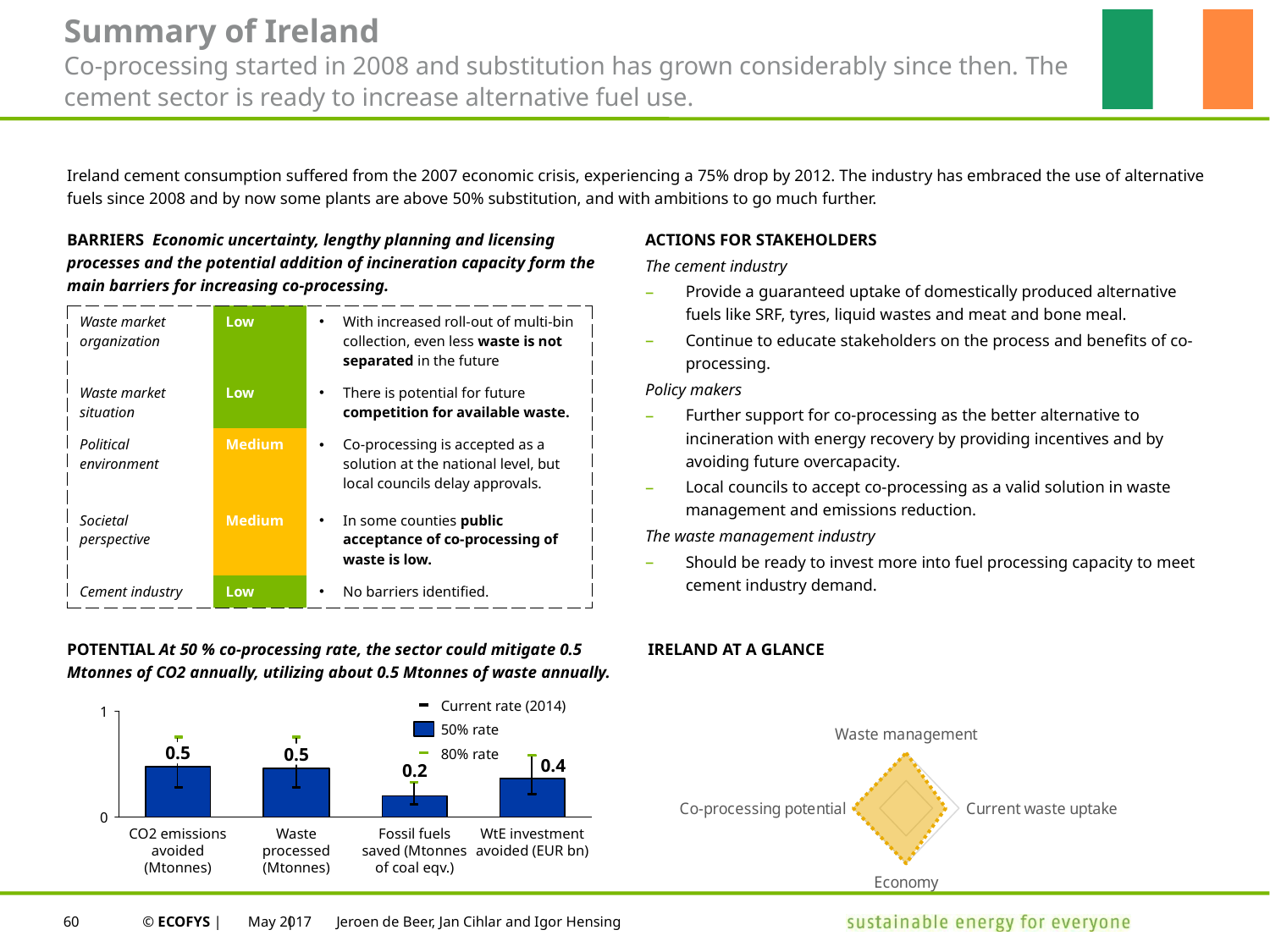
In the bar chart under POTENTIAL, what is the 50% rate value for Fossil fuels saved (Mtonnes of coal eqv.)? 0.2 In the bar chart under POTENTIAL, what is the 50% rate value for WtE investment avoided (EUR bn)? 0.4 In the bar chart under POTENTIAL, what is the 50% rate value for Waste processed (Mtonnes)? 0.5 In the bar chart under POTENTIAL, is the 50% rate value for WtE investment avoided greater or less than 1? less In the bar chart under POTENTIAL, which is larger at the 50% rate: Waste processed or WtE investment avoided? Waste processed In the bar chart under POTENTIAL, what is the difference between the 50% rate values for CO2 emissions avoided and Fossil fuels saved? 0.3 How many series does the legend of the bar chart under POTENTIAL list? 3 In the bar chart under POTENTIAL, what is the 50% rate value for CO2 emissions avoided (Mtonnes)? 0.5 In the bar chart under POTENTIAL, which category has the lowest 50% rate value? Fossil fuels saved (Mtonnes of coal eqv.) In the IRELAND AT A GLANCE radar chart, what are the four axis labels? Waste management, Current waste uptake, Economy, Co-processing potential How many categories are shown on the x axis of the bar chart under POTENTIAL? 4 What kind of chart is shown under the POTENTIAL heading? Bar chart